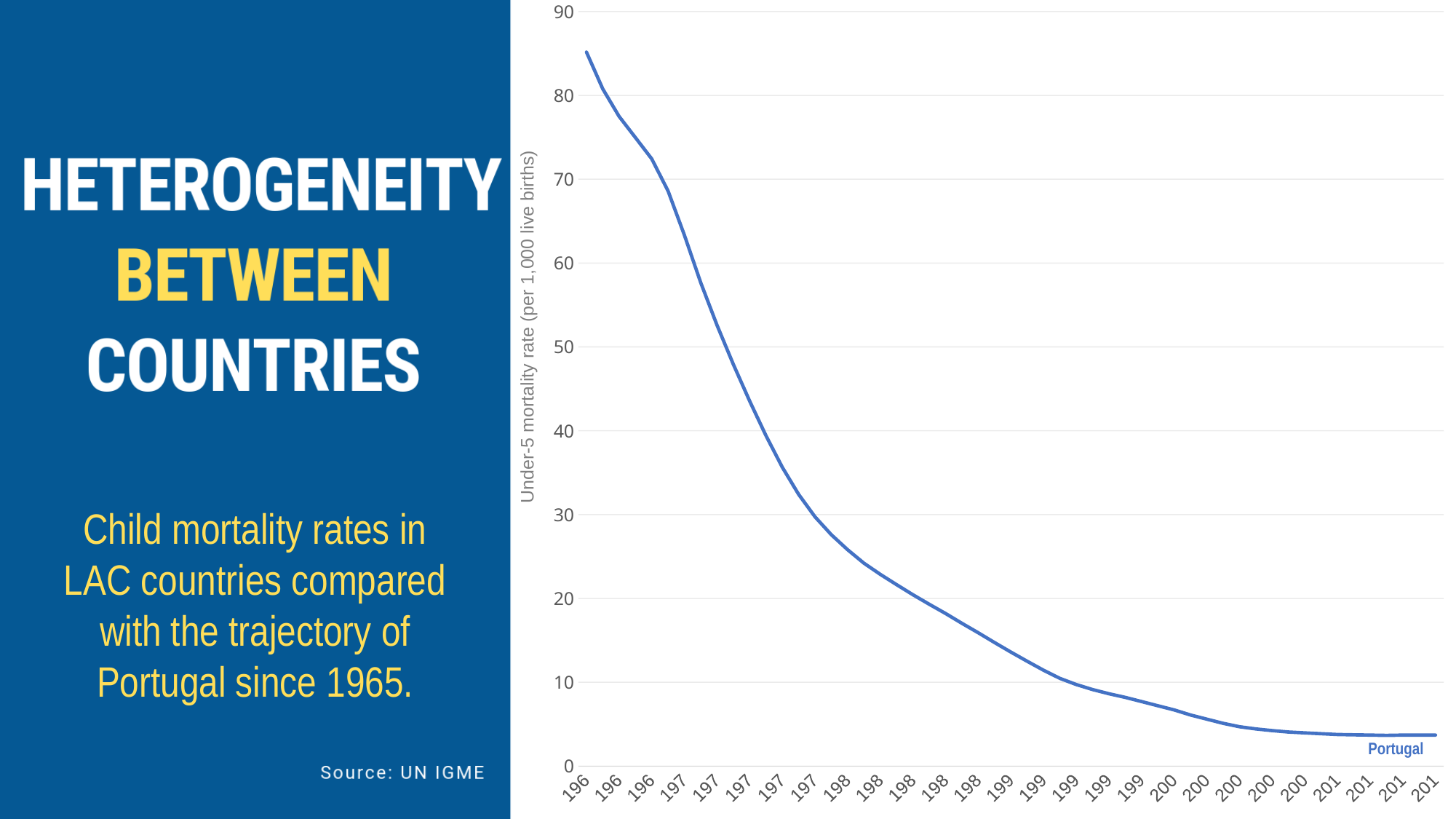
What kind of chart is shown on the slide? line chart What is the title of the vertical axis? Under-5 mortality rate (per 1,000 live births) What is the highest value shown on the vertical axis? 90 Is the value at the leftmost point of the line greater or less than 80? greater Is the value at the rightmost point of the line greater or less than 10? less Is the value at the leftmost point of the line greater or less than 90? less Which country does the plotted line represent? Portugal Does the plotted line rise or fall as you move from left to right along the x axis? fall How many lines (series) are plotted on the chart? 1 Which is larger, the value at the leftmost point of the line or the value at the rightmost point? the leftmost point